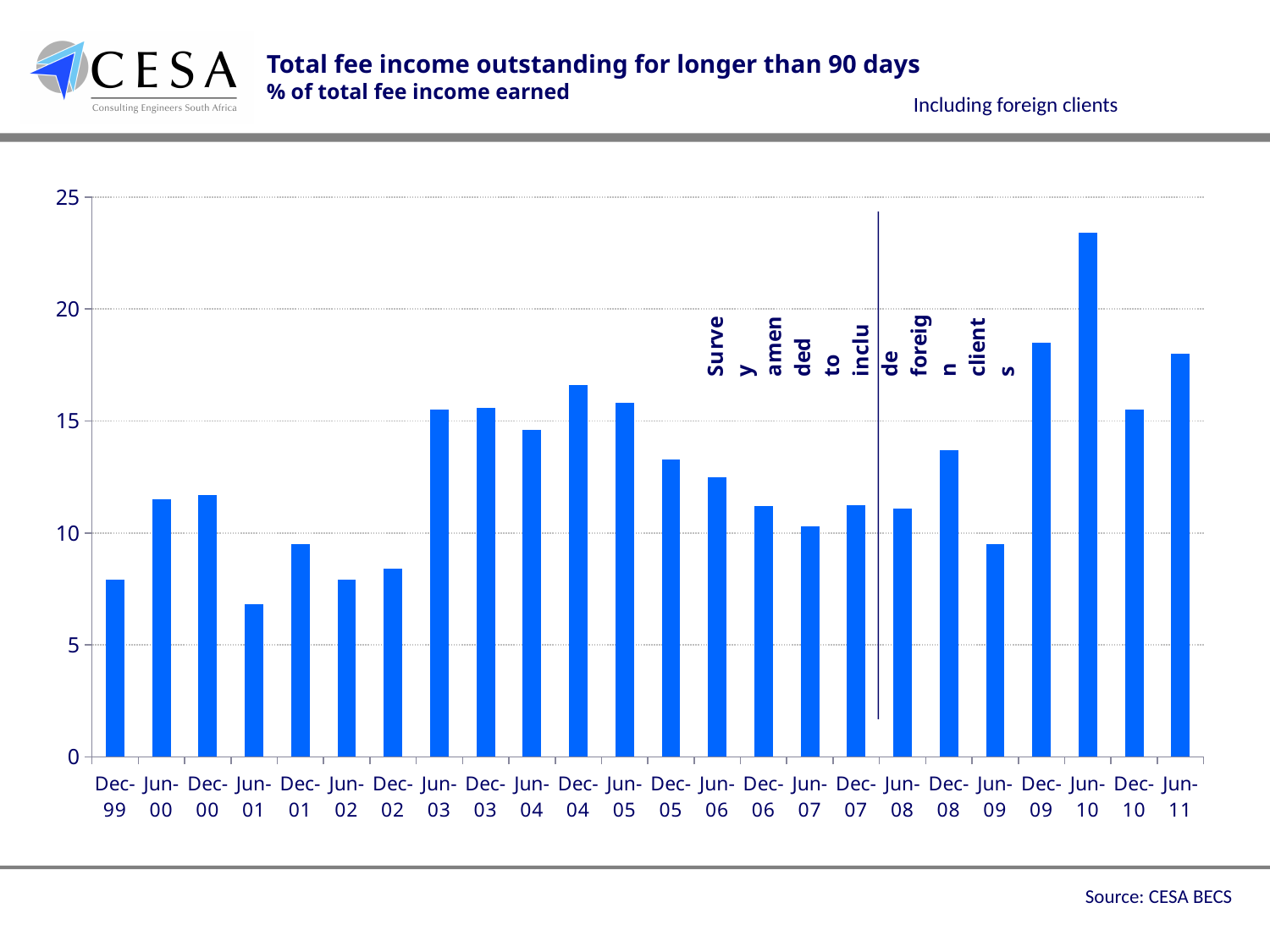
Do the values rise or fall from Jun-05 to Jun-07? fall What is the title of the chart? Total fee income outstanding for longer than 90 days What kind of chart is shown on the slide? Bar chart Is the value for Dec-99 greater or less than 10? less Which is larger, the value for Jun-10 or the value for Dec-10? Jun-10 Is the value for Jun-10 greater or less than 20? greater Which period has the lowest value on the chart? Jun-01 Is the value for Dec-09 greater or less than 15? greater How many bars (periods) are plotted on the chart? 24 Which period has the highest value on the chart? Jun-10 Which is larger, the value for Dec-04 or the value for Jun-06? Dec-04